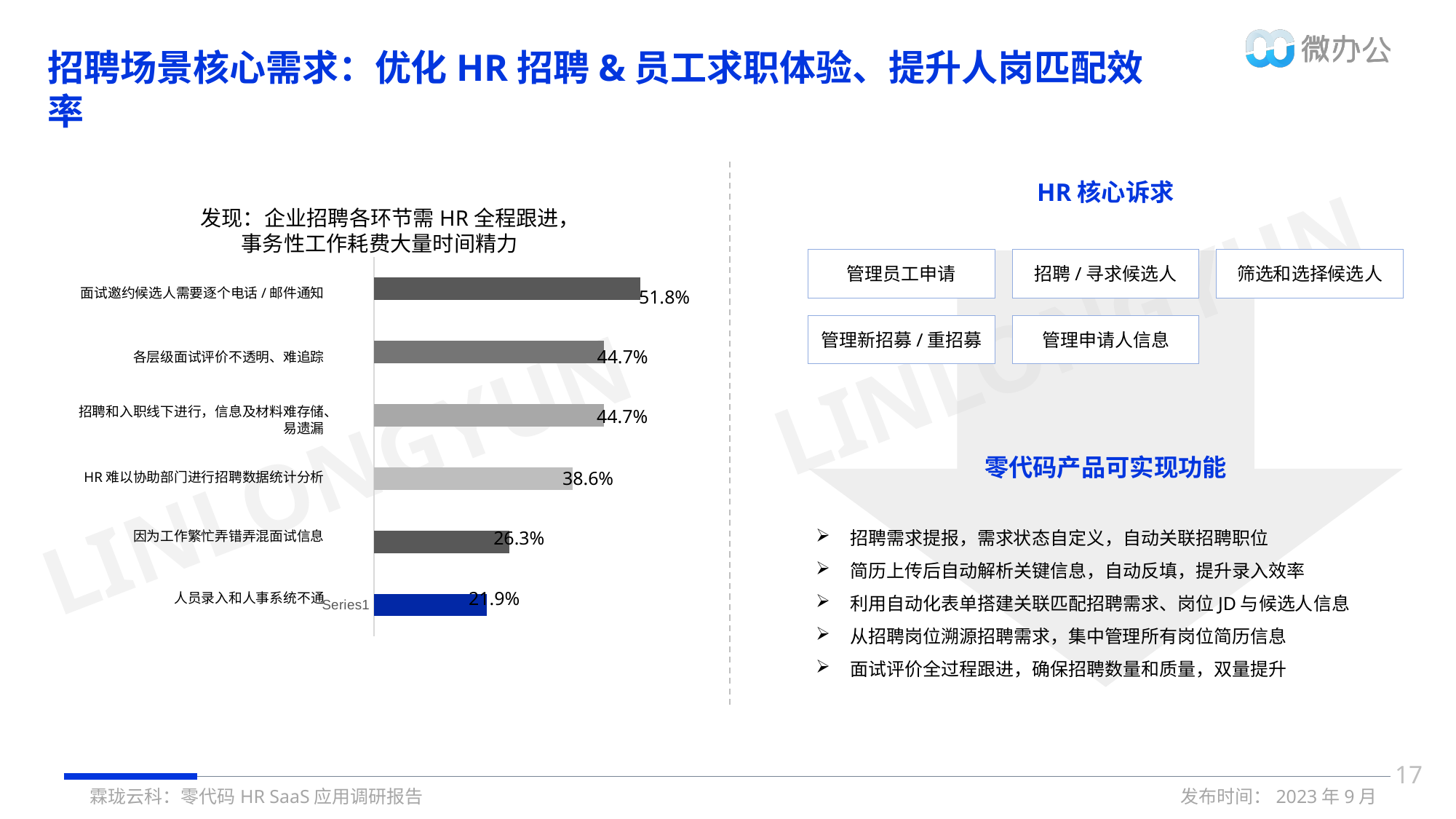
Which two categories share the same value of 44.7%? 各层级面试评价不透明、难追踪 and 招聘和入职线下进行，信息及材料难存储、易遗漏 Which is larger: the value for "HR难以协助部门进行招聘数据统计分析" or the value for "因为工作繁忙弄错弄混面试信息"? HR难以协助部门进行招聘数据统计分析 Which category has the lowest value in the chart? 人员录入和人事系统不通 What type of chart is shown on the slide? Bar chart Which category has the highest value in the chart? 面试邀约候选人需要逐个电话/邮件通知 What is the difference between the values for "各层级面试评价不透明、难追踪" and "HR难以协助部门进行招聘数据统计分析"? 6.1% What is the value for "人员录入和人事系统不通"? 21.9% What is the value for "面试邀约候选人需要逐个电话/邮件通知"? 51.8% What is the value for "因为工作繁忙弄错弄混面试信息"? 26.3% What is the difference between the values for "面试邀约候选人需要逐个电话/邮件通知" and "人员录入和人事系统不通"? 29.9% How many categories are plotted in the bar chart? 6 What is the value for "HR难以协助部门进行招聘数据统计分析"? 38.6%